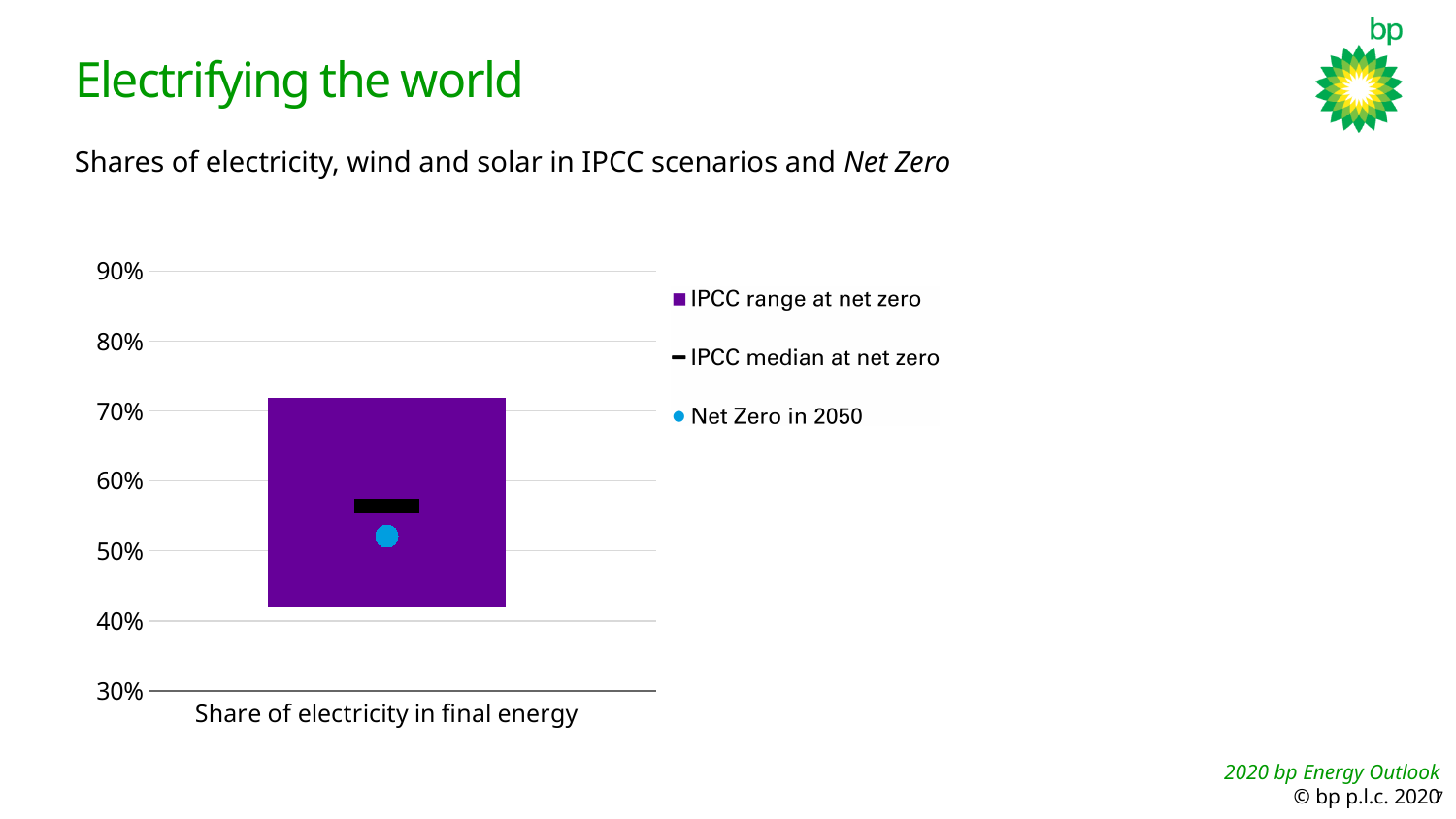
Which is higher, the IPCC median at net zero or the Net Zero in 2050 value? IPCC median at net zero Is the Net Zero in 2050 value greater or less than 60%? less Is the bottom of the IPCC range at net zero greater or less than 50%? less What is the label of the category on the x axis? Share of electricity in final energy How many categories are shown on the x axis? 1 What kind of chart is shown on the slide? bar chart Is the IPCC median at net zero greater or less than 50%? greater How many series does the legend list? 3 Which legend entry is shown with a purple square marker? IPCC range at net zero